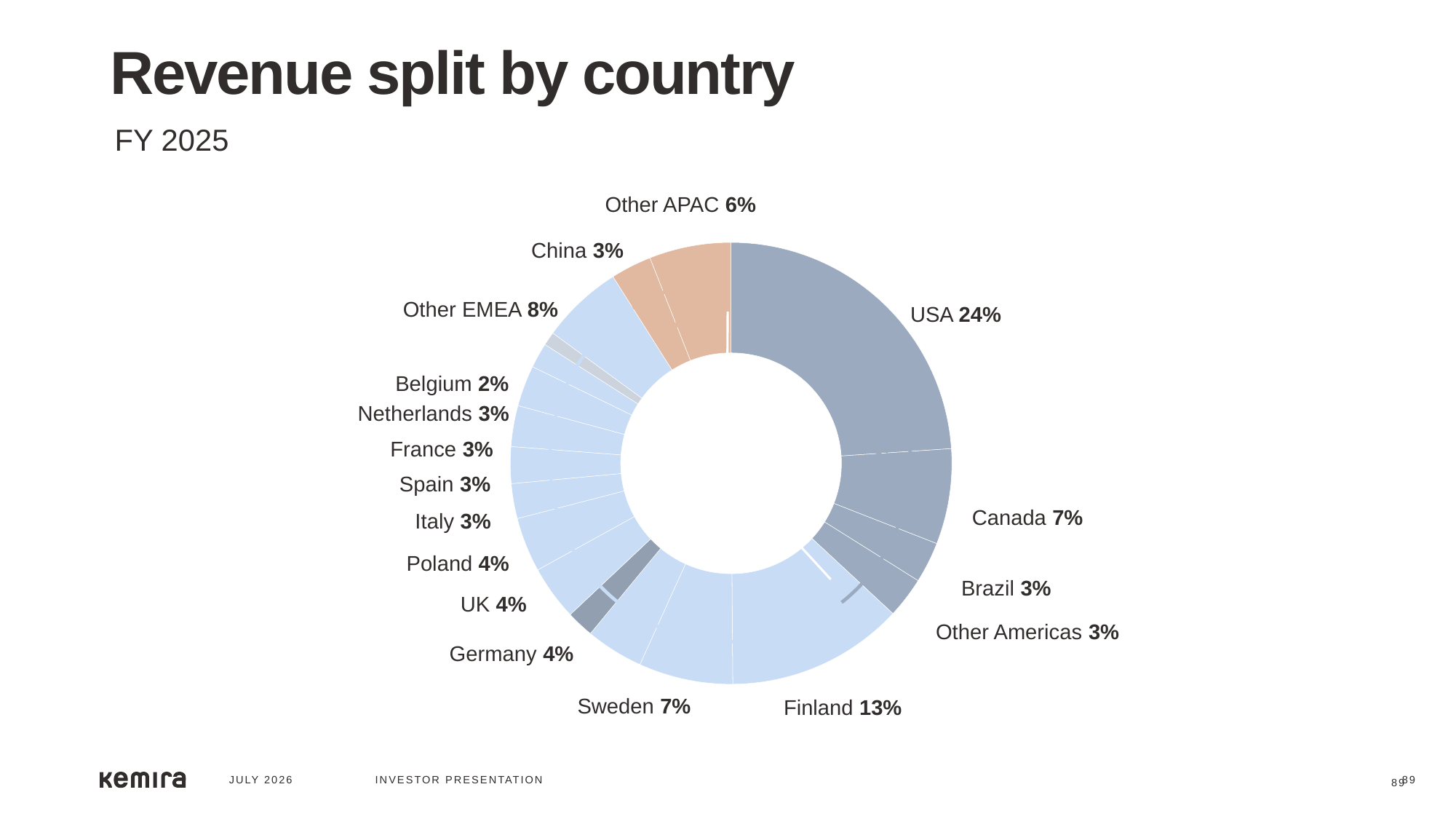
Which country has the smallest share of revenue? Belgium What is the difference in revenue share between Other EMEA and Other APAC? 2 percentage points What is the revenue share for Finland? 13% What percentage of revenue comes from Other EMEA? 8% What share of revenue does the USA account for? 24% Which country or region has the largest share of revenue? USA What is the revenue share shown for Belgium? 2% How many countries or regions are shown in the chart? 17 What type of chart is shown on the slide? Donut (pie) chart What is the difference in revenue share between the USA and Finland? 11 percentage points Which fiscal year does the chart cover? FY 2025 Which has a larger revenue share, Canada or Germany? Canada